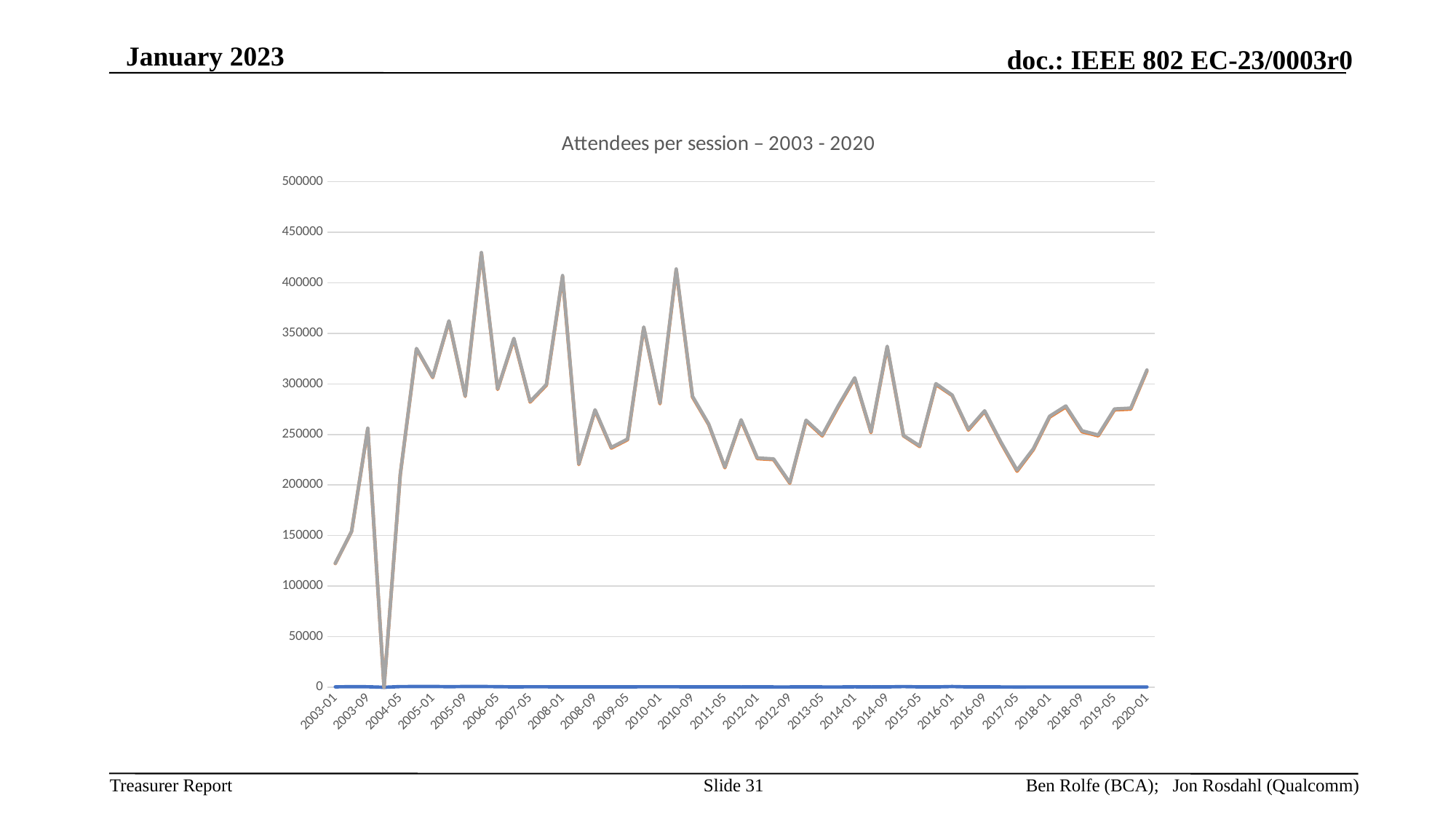
Is the value for 2008-01 greater or less than 350000? greater Is the value for 2014-09 greater or less than 300000? greater Which is larger, the value for 2003-01 or the value for 2003-09? 2003-09 Is the value for 2017-05 greater or less than 250000? less What is the title of the chart? Attendees per session – 2003 - 2020 What kind of chart is shown on the slide? line chart What is the highest value shown on the vertical axis of the chart? 500000 Between 2018-09 and 2020-01, does the line generally rise or fall? rise